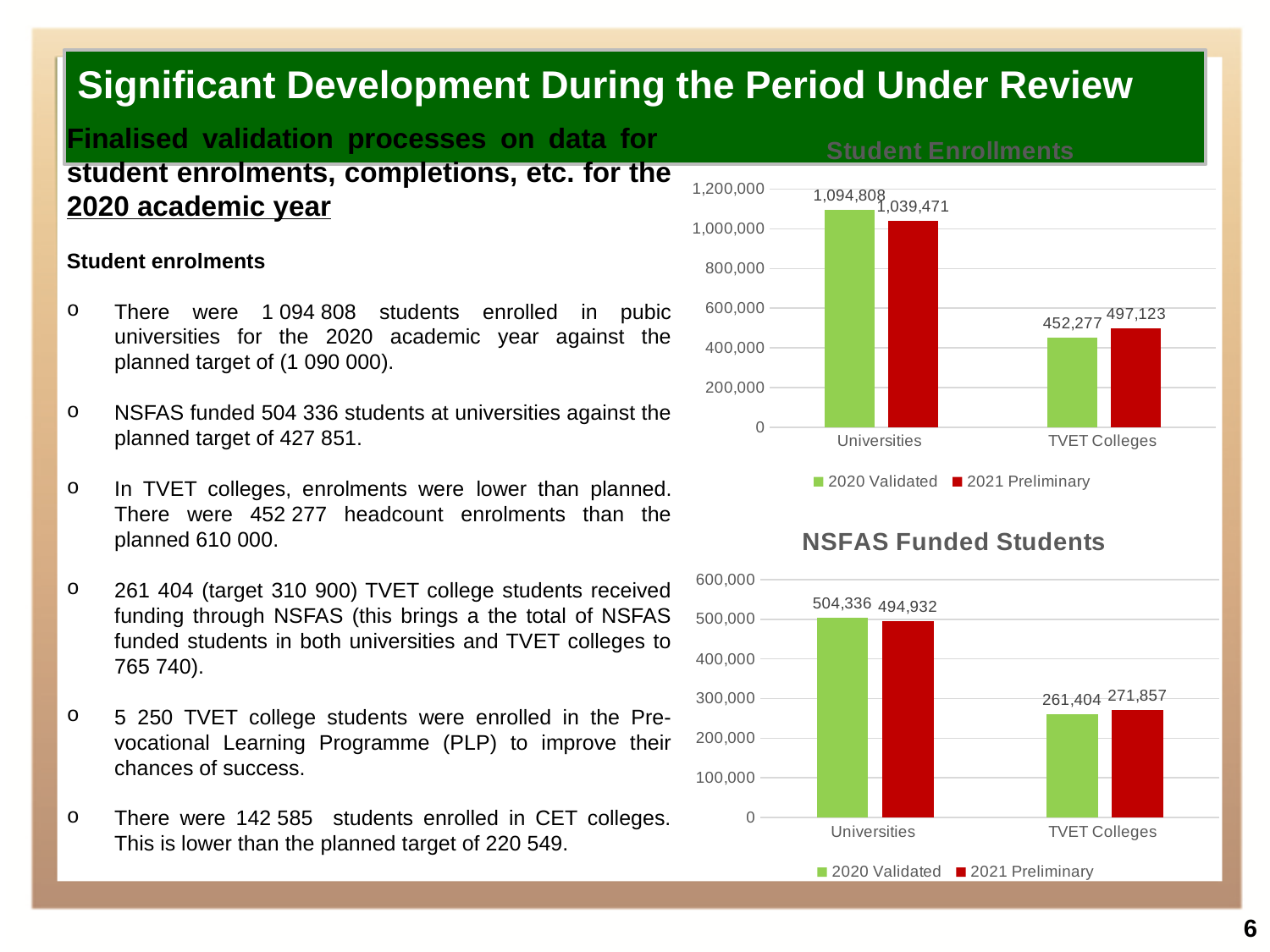
What type of chart is the NSFAS Funded Students chart? Bar chart In the NSFAS Funded Students chart, which category has the highest 2020 Validated value? Universities In the Student Enrollments chart, is the 2020 Validated value for TVET Colleges greater or less than 600,000? less In the Student Enrollments chart, what is the 2020 Validated value for Universities? 1,094,808 In the NSFAS Funded Students chart, what is the difference between the 2021 Preliminary and 2020 Validated values for TVET Colleges? 10,453 How many categories are shown on the x axis of the Student Enrollments chart? 2 In the Student Enrollments chart, what is the difference between the 2020 Validated and 2021 Preliminary values for Universities? 55,337 In the Student Enrollments chart, which is larger for TVET Colleges: 2020 Validated or 2021 Preliminary? 2021 Preliminary In the NSFAS Funded Students chart, what is the 2020 Validated value for TVET Colleges? 261,404 In the NSFAS Funded Students chart, what is the 2021 Preliminary value for Universities? 494,932 How many series does the legend of the NSFAS Funded Students chart list? 2 In the Student Enrollments chart, what is the 2021 Preliminary value for TVET Colleges? 497,123